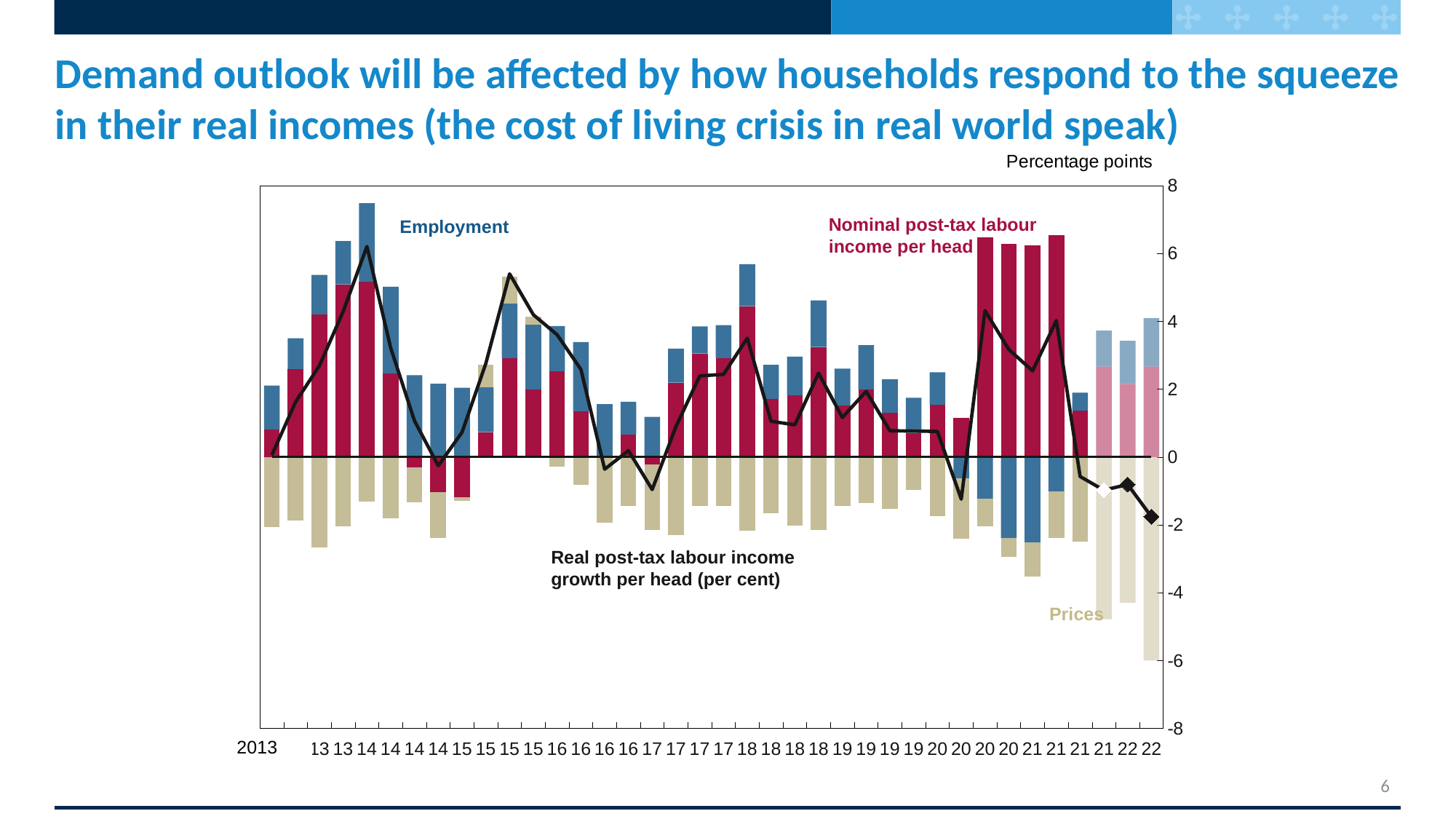
What is the lowest value shown on the vertical axis? -8 Does the real post-tax labour income growth line rise or fall from its 2021 peak to the end of 2022? fall What is the highest value shown on the vertical axis? 8 Is the Prices contribution in the final 2022 quarter greater or less than -4? less Is the real post-tax labour income growth line at the final 2022 quarter greater or less than 0? less How many series are labelled on the chart? 4 Is the peak of the real post-tax labour income growth line higher in 2014 or in 2018? 2014 Is the peak of the real post-tax labour income growth line in 2014 greater or less than 4? greater What colour are the Employment bars? blue What unit is shown at the top of the right-hand axis? Percentage points What kind of chart is shown on the slide? bar chart with a line